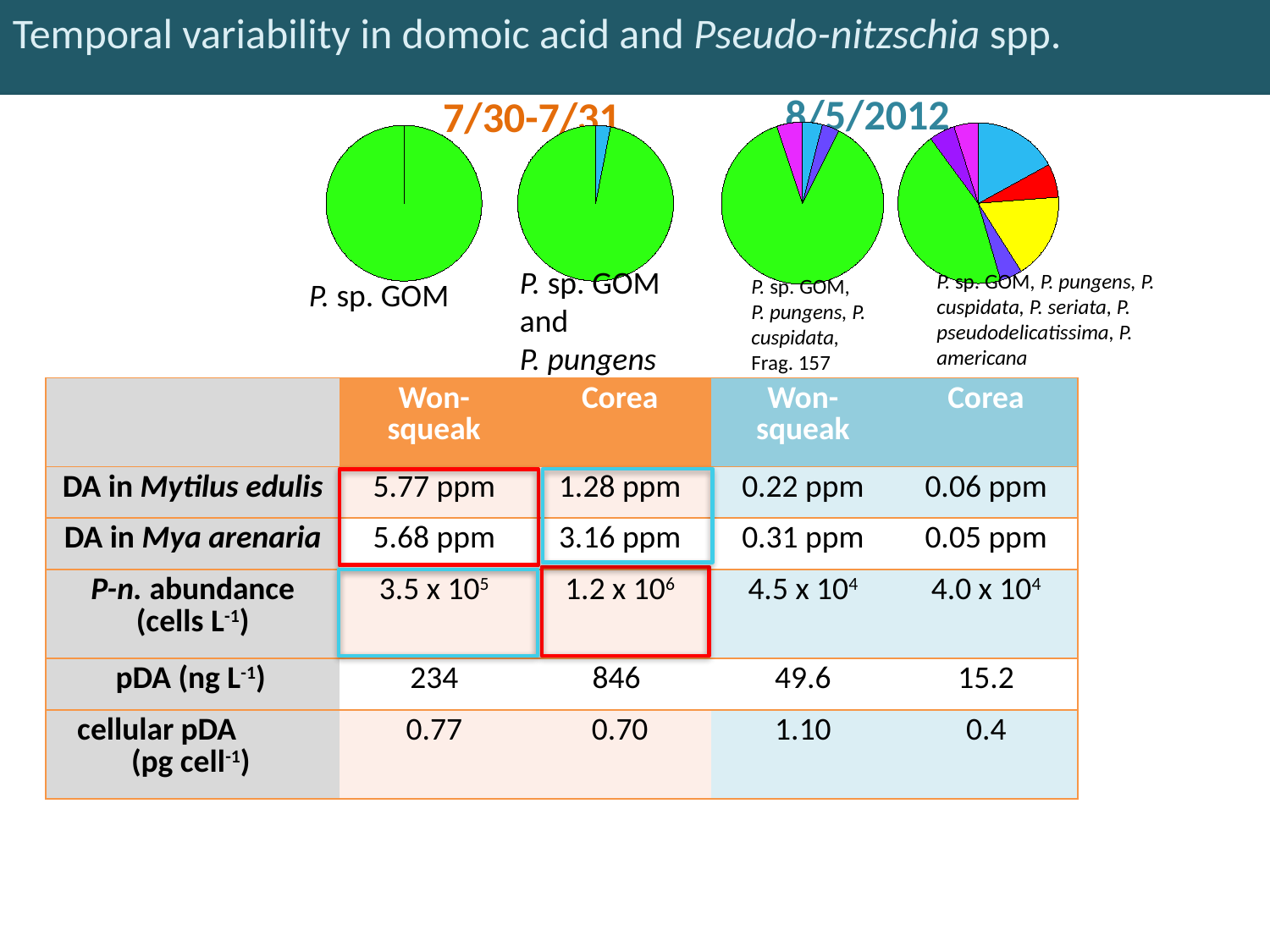
Which date label is shown above the two left-hand pie charts? 7/30-7/31 What kind of chart is used to show the Pseudo-nitzschia species composition on the slide? pie chart How many slices does the second pie chart from the left (labelled P. sp. GOM and P. pungens) have? 2 In the second pie chart from the left, which slice is larger, the green one or the blue one? the green one How many pie charts are shown on the slide? 4 Which of the four pie charts is divided into the most slices? the rightmost pie (8/5/2012, P. sp. GOM, P. pungens, P. cuspidata, P. seriata, P. pseudodelicatissima, P. americana) What is the caption under the leftmost pie chart? P. sp. GOM